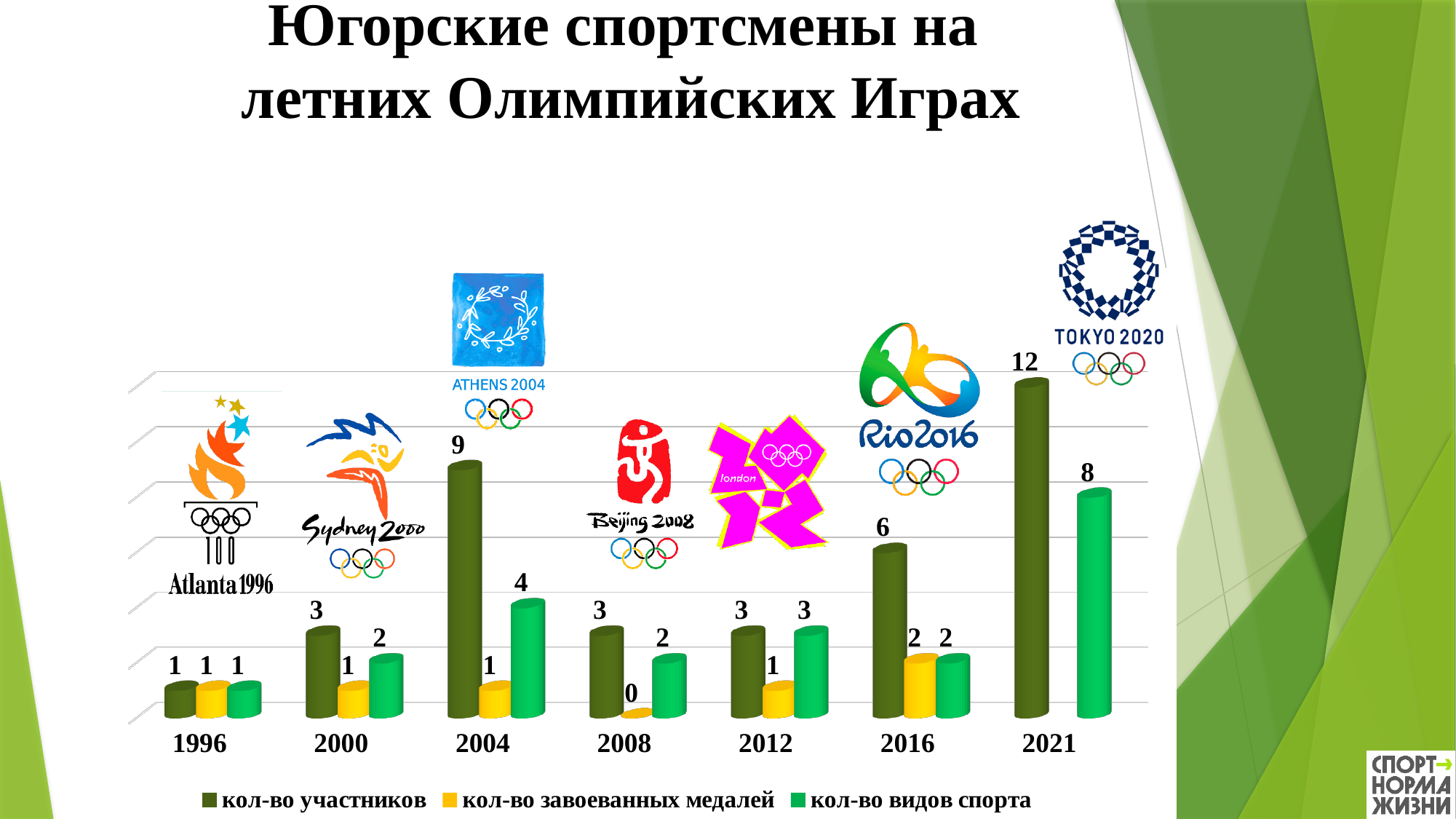
Which is larger: кол-во видов спорта in 2004 or in 2012? 2004 What is the value of кол-во завоеванных медалей for 2016? 2 How many years (categories) are shown on the x axis? 7 In which year is кол-во участников highest? 2021 In which year is кол-во завоеванных медалей lowest? 2008 What is the value of кол-во видов спорта for 2021? 8 How many series does the legend list? 3 What kind of chart is shown on the slide? bar chart What is the value of кол-во завоеванных медалей for 2008? 0 What is the difference in кол-во участников between 2021 and 2016? 6 What is the value of кол-во участников for 2004? 9 Which series is shown in yellow in the legend? кол-во завоеванных медалей